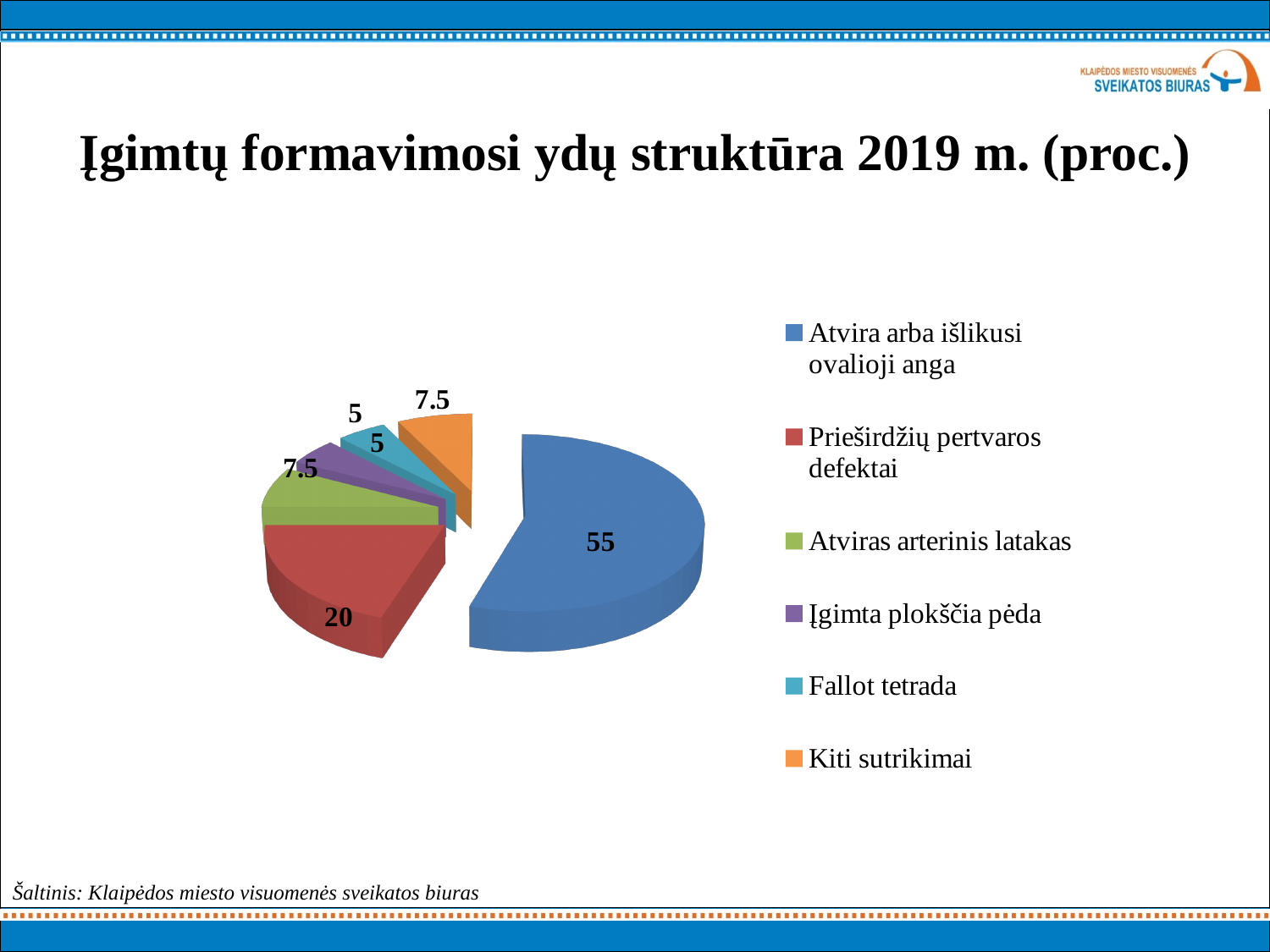
What is the value for "Atviras arterinis latakas"? 7.5 Which is larger: the value for "Prieširdžių pertvaros defektai" or the value for "Kiti sutrikimai"? Prieširdžių pertvaros defektai What is the value for "Atvira arba išlikusi ovalioji anga"? 55 Which category has the largest slice of the pie? Atvira arba išlikusi ovalioji anga How many categories does the pie chart have? 6 What is the value for "Kiti sutrikimai"? 7.5 What is the value for "Fallot tetrada"? 5 What is the difference between the values for "Atvira arba išlikusi ovalioji anga" and "Prieširdžių pertvaros defektai"? 35 What type of chart is shown on the slide? pie chart What is the title of the chart? Įgimtų formavimosi ydų struktūra 2019 m. (proc.) What is the value for "Prieširdžių pertvaros defektai"? 20 What colour is the slice for "Įgimta plokščia pėda"? purple